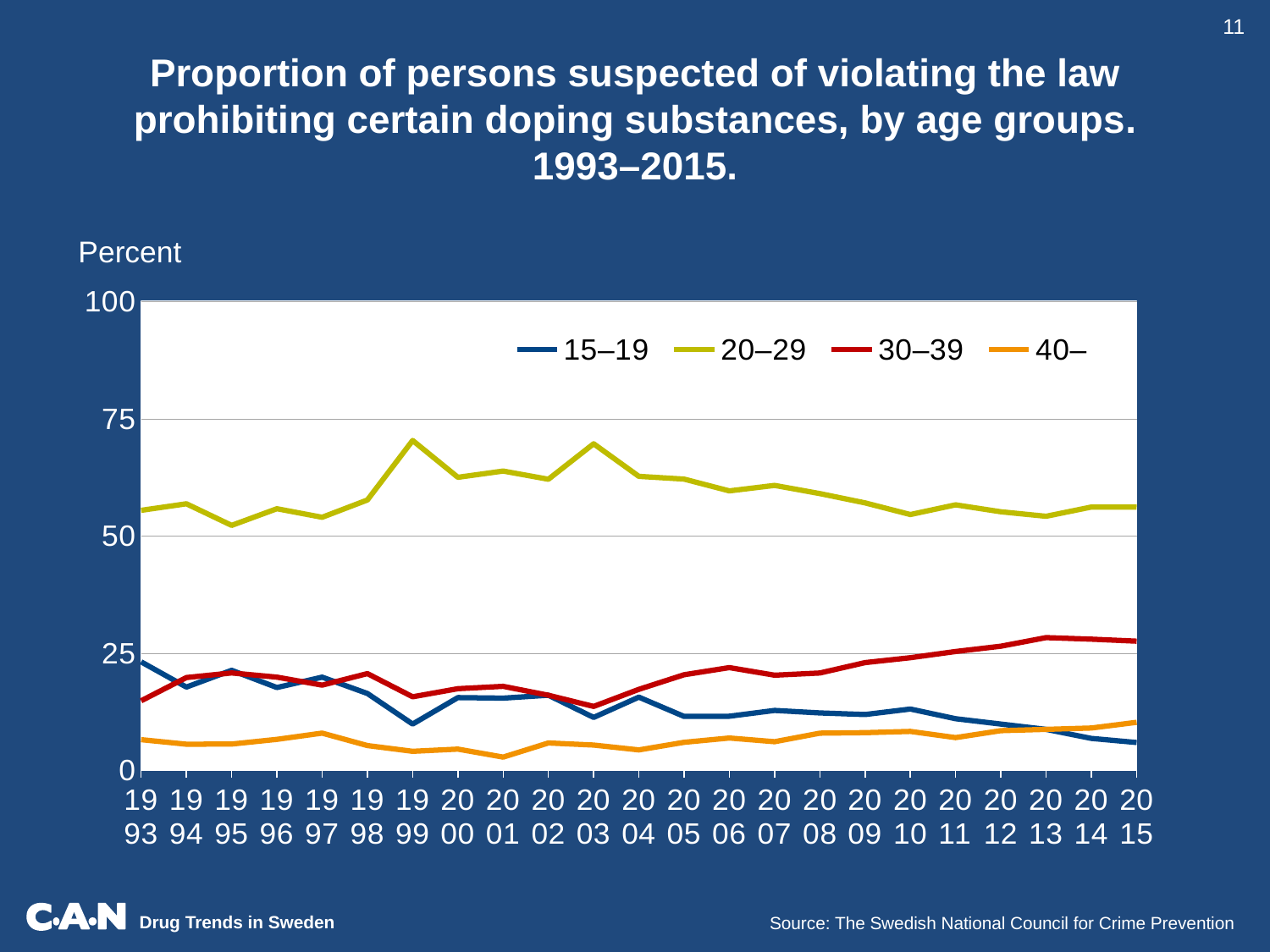
How many years are plotted along the x axis? 23 Is the value for the 30–39 age group in 2013 greater or less than 25? greater In 2015, which is larger: the value for the 30–39 age group or the 15–19 age group? 30–39 Is the value for the 20–29 age group in 1999 greater or less than 50? greater How many series does the legend list? 4 Is the value for the 40– age group in 2001 greater or less than 25? less What label is shown above the y axis of the chart? Percent Which age group has the lowest proportion in 1993? 40– Does the value for the 15–19 age group rise or fall overall from 1993 to 2015? fall What kind of chart is shown on the slide? line chart Which age group has the highest proportion in 2015? 20–29 Does the value for the 30–39 age group rise or fall overall from 1993 to 2015? rise